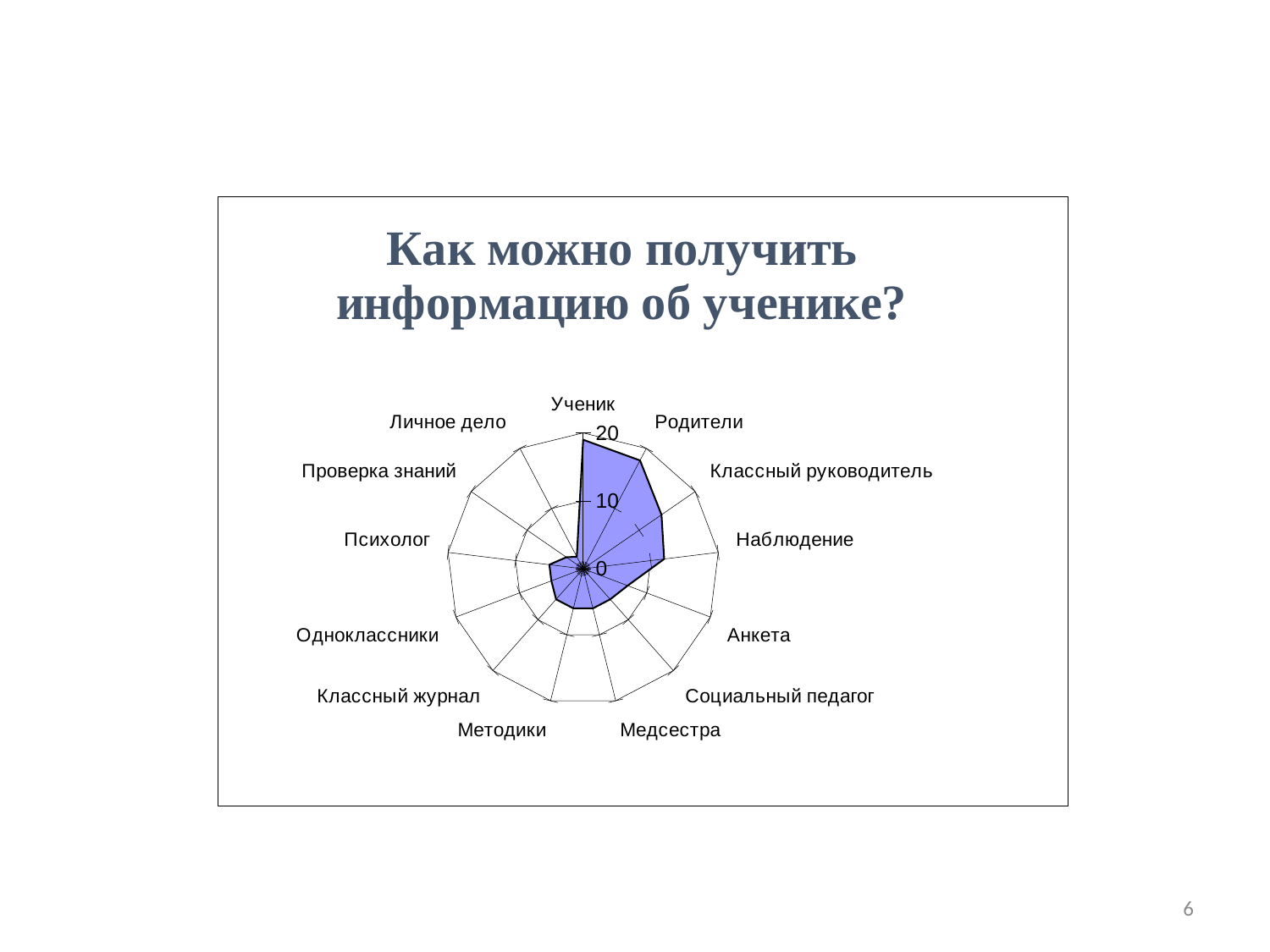
What is the highest tick value shown on the radar chart's axis? 20 Is the value for Психолог greater or less than 10? less Which is larger, the value for Родители or the value for Классный журнал? Родители Which category has the highest value on the radar chart? Ученик Is the value for Классный руководитель greater or less than 10? greater Is the value for Одноклассники greater or less than 10? less What kind of chart is shown on the slide? radar chart How many categories are plotted on the radar chart? 13 Which is larger, the value for Ученик or the value for Методики? Ученик